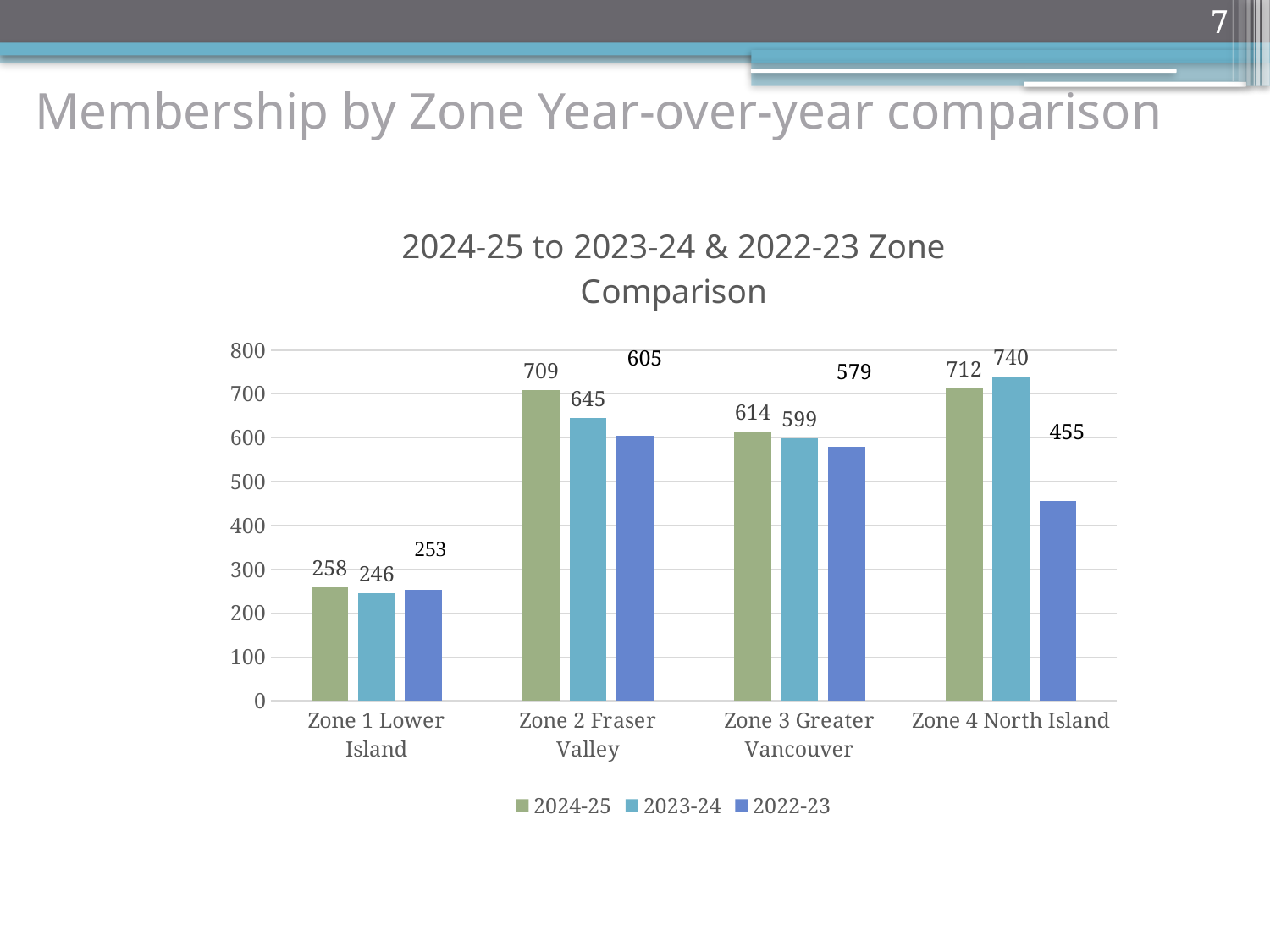
What is the 2023-24 value for Zone 1 Lower Island? 246 How many zones are shown on the x axis? 4 Is the 2022-23 value for Zone 2 Fraser Valley greater or less than 500? greater Which zone has the highest 2023-24 value? Zone 4 North Island What is the difference between the 2023-24 and 2022-23 values for Zone 4 North Island? 285 What is the 2022-23 value for Zone 4 North Island? 455 What kind of chart is shown on the slide? Bar chart What is the title of the chart? 2024-25 to 2023-24 & 2022-23 Zone Comparison Which zone has the lowest 2024-25 value? Zone 1 Lower Island Which is larger for Zone 3 Greater Vancouver: the 2024-25 value or the 2022-23 value? 2024-25 How many series does the legend list? 3 What is the 2024-25 value for Zone 2 Fraser Valley? 709